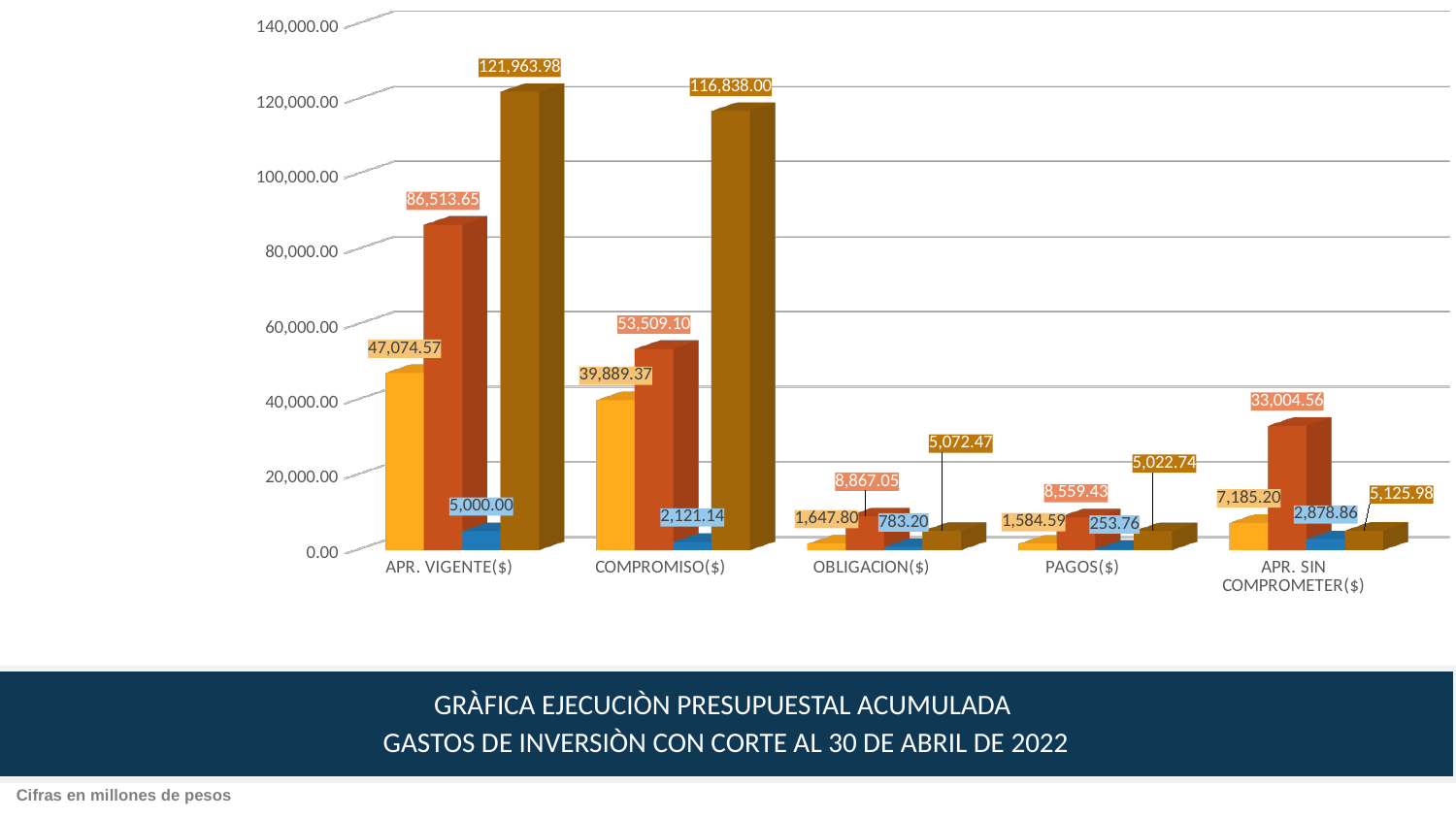
What is the value of the orange-red bar for APR. SIN COMPROMETER($)? 33,004.56 Is the value of the dark gold bar for APR. VIGENTE($) greater or less than 120,000.00? greater What is the value of the yellow bar for APR. VIGENTE($)? 47,074.57 What kind of chart is shown on the slide? Bar chart What is the value of the blue bar for OBLIGACION($)? 783.20 What is the value of the dark gold bar for COMPROMISO($)? 116,838.00 What is the difference between the dark gold bars for APR. VIGENTE($) and COMPROMISO($)? 5,125.98 Which category has the highest single bar value on the chart? APR. VIGENTE($) Which is larger: the orange-red bar for APR. VIGENTE($) or the orange-red bar for COMPROMISO($)? APR. VIGENTE($) How many categories are shown on the x axis? 5 What is the difference between the yellow bars for APR. VIGENTE($) and COMPROMISO($)? 7,185.20 What is the value of the orange-red bar for PAGOS($)? 8,559.43